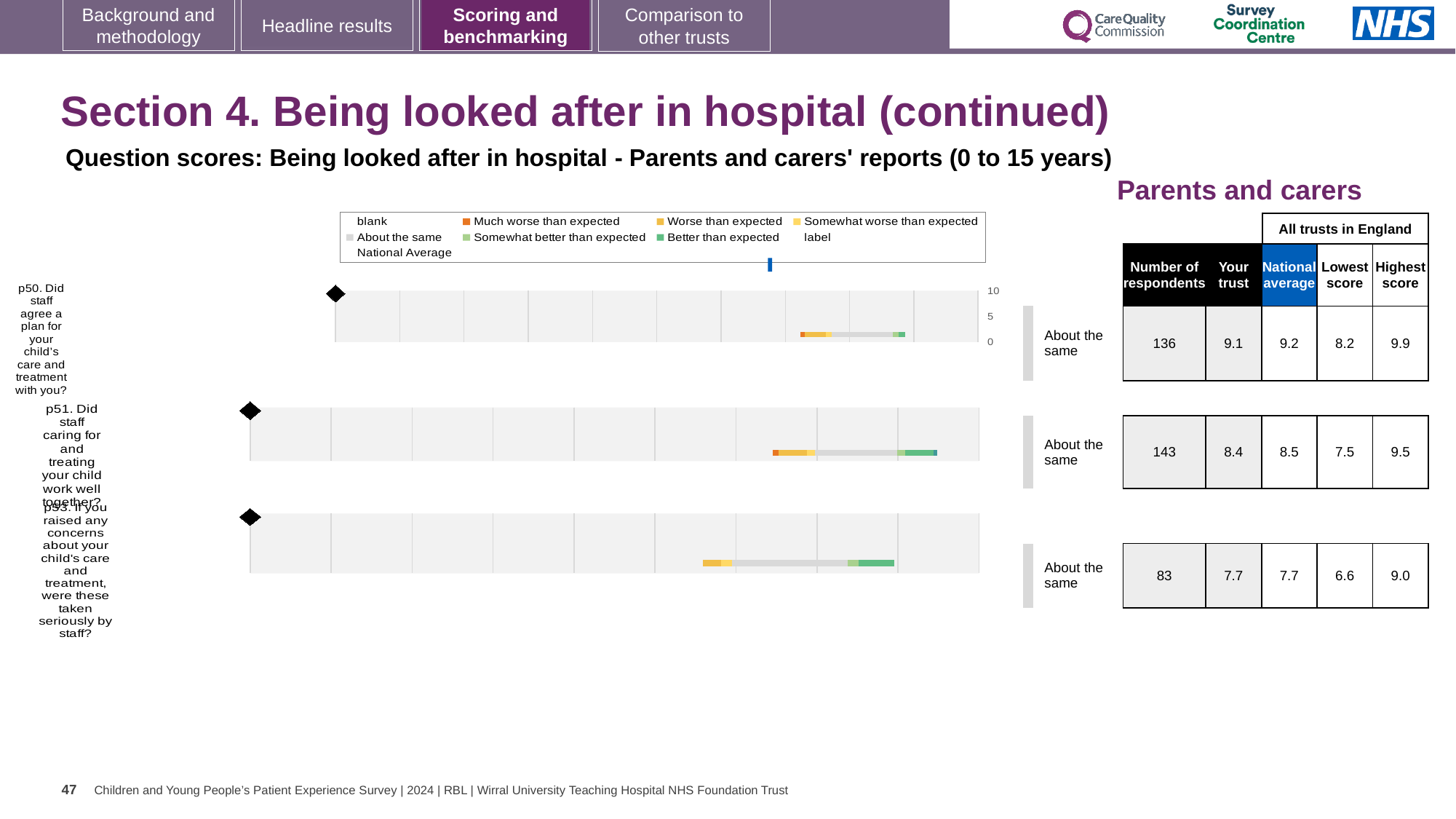
What is the lowest score among all trusts in England for p50? 8.2 Which is larger for p50: the 'Your trust' score or the national average? National average In the chart legend, which category is shown in orange? Much worse than expected Which question has the fewest respondents? p53 What is the difference between the highest score and the lowest score for p51? 2.0 Which question has the highest 'Your trust' score? p50 What is the 'Your trust' score for p50 (Did staff agree a plan for your child's care and treatment with you?)? 9.1 What is the national average score for p51 (Did staff caring for and treating your child work well together?)? 8.5 What is the highest value shown on the vertical axis of the p50 chart? 10 How many respondents answered p53 (If you raised any concerns about your child's care and treatment, were these taken seriously by staff?)? 83 How many question charts are shown on the slide? 3 What kind of chart is used for each question on the slide? bar chart